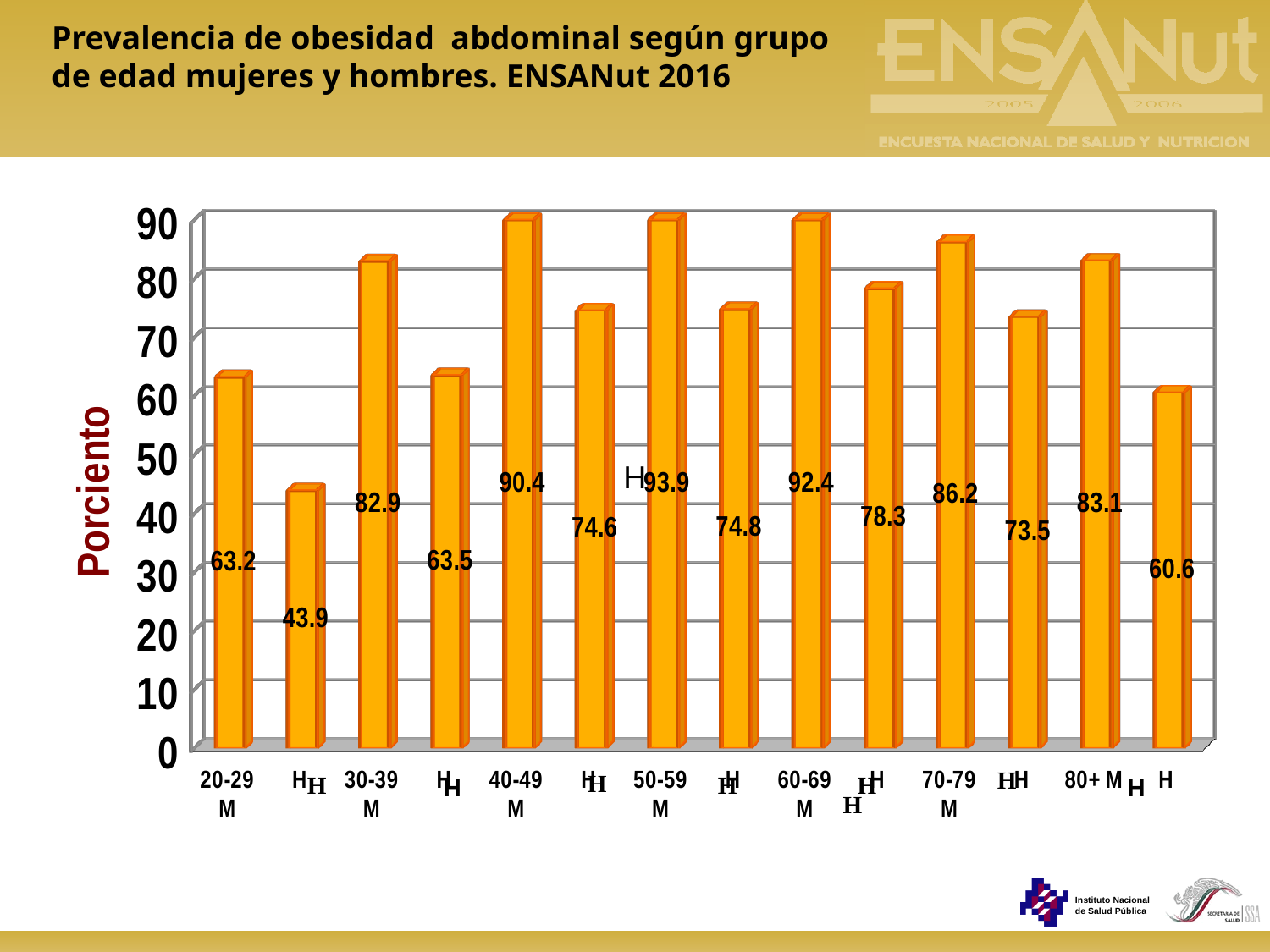
What kind of chart is shown on the slide? Bar chart What is the difference between the values for women and men aged 40-49? 15.8 Which bar has the lowest value? 20-29 H (43.9) What is the label on the vertical axis? Porciento What is the value for men (H) aged 80+? 60.6 Which is larger, the value for women aged 60-69 or the value for women aged 70-79? Women aged 60-69 (92.4) How many bars are plotted in the chart? 14 What is the value for women (M) aged 20-29? 63.2 What is the value for men (H) aged 20-29? 43.9 Is the value for men aged 30-39 greater or less than 70? less Which bar has the highest value? 50-59 M (93.9) What is the value for women (M) aged 50-59? 93.9